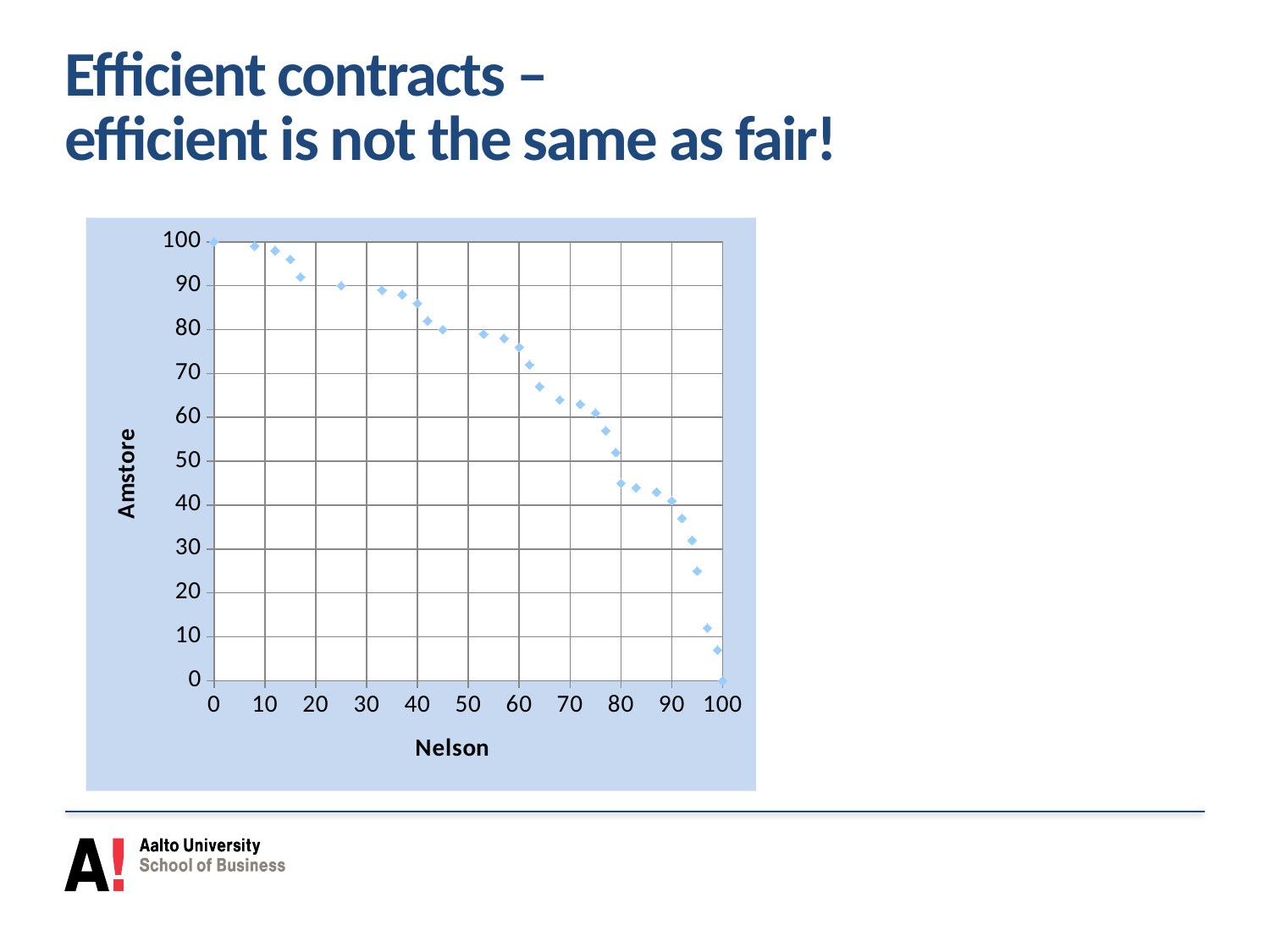
Is the Amstore value at Nelson = 60 greater or less than 70? greater At which Nelson value is the Amstore value highest? 0 What kind of chart is shown on the slide? scatter chart Is the Amstore value at Nelson = 90 greater or less than 50? less What is the label of the y axis? Amstore Is the Amstore value at Nelson = 95 greater or less than 30? less What is the Amstore value when Nelson is 0? 100 What is the label of the x axis? Nelson Do the Amstore values rise or fall as Nelson increases along the x axis? fall What is the Amstore value when Nelson is 100? 0 At which Nelson value is the Amstore value lowest? 100